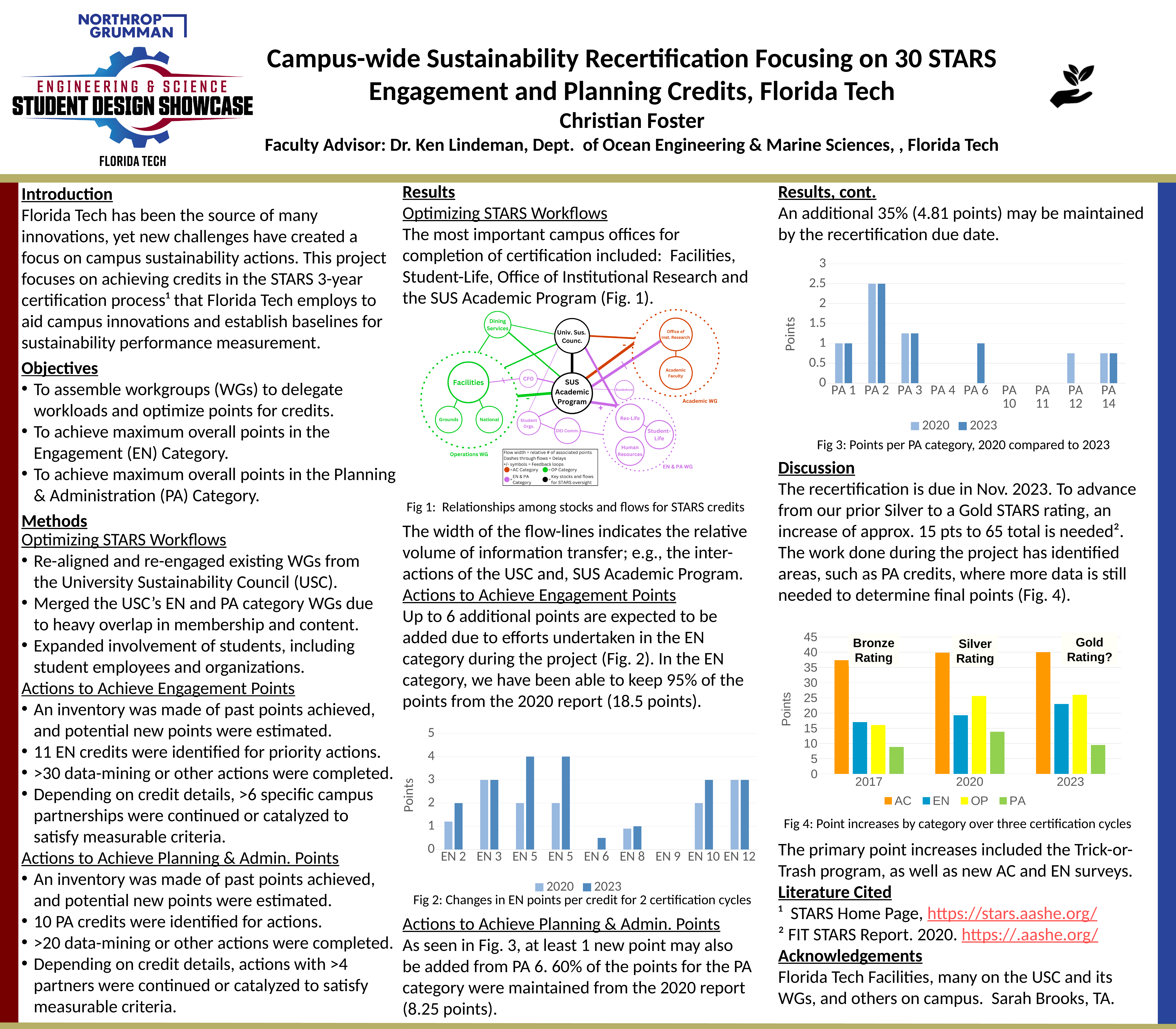
In the chart titled 'Fig 3: Points per PA category, 2020 compared to 2023', which PA category has the highest 2023 value? PA 2 In the chart titled 'Fig 2: Changes in EN points per credit for 2 certification cycles', is the 2023 value for EN 5 greater or less than 3? greater In the chart titled 'Fig 4: Point increases by category over three certification cycles', which category has the highest value in 2023? AC In the chart titled 'Fig 3: Points per PA category, 2020 compared to 2023', how many PA categories are shown on the x axis? 9 In the chart titled 'Fig 3: Points per PA category, 2020 compared to 2023', is the 2020 value for PA 12 greater or less than 1? less In the chart titled 'Fig 4: Point increases by category over three certification cycles', do the EN values rise or fall from 2017 to 2023? rise In the chart titled 'Fig 2: Changes in EN points per credit for 2 certification cycles', how many series does the legend list? 2 In the chart titled 'Fig 2: Changes in EN points per credit for 2 certification cycles', which is larger for EN 10, the 2020 value or the 2023 value? 2023 In the chart titled 'Fig 2: Changes in EN points per credit for 2 certification cycles', is the 2023 value for EN 6 greater or less than 1? less What kind of chart is 'Fig 3: Points per PA category, 2020 compared to 2023'? bar chart In the chart titled 'Fig 4: Point increases by category over three certification cycles', how many series does the legend list? 4